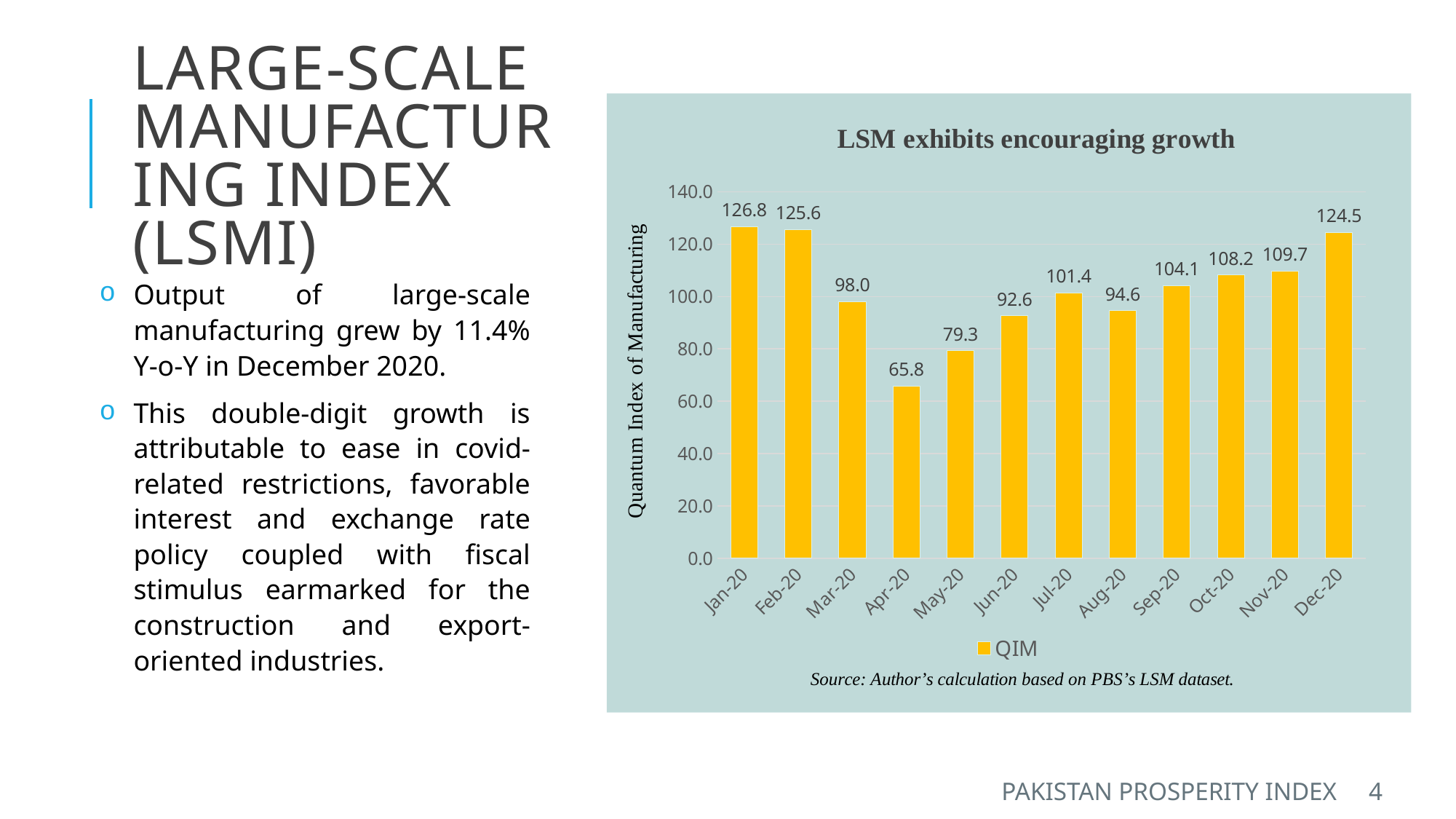
What is the QIM value for Apr-20? 65.8 Which month has a higher QIM value, Jun-20 or Aug-20? Aug-20 What is the title of the chart? LSM exhibits encouraging growth Which month has the lowest QIM value? Apr-20 What is the QIM value for Dec-20? 124.5 What is the difference between the QIM values for Jan-20 and Apr-20? 61.0 Is the QIM value for May-20 greater or less than 80.0? less What kind of chart is shown on the slide? bar chart How many months are shown on the x axis? 12 What is the QIM value for Sep-20? 104.1 Which month has the highest QIM value? Jan-20 How many series does the legend list? 1